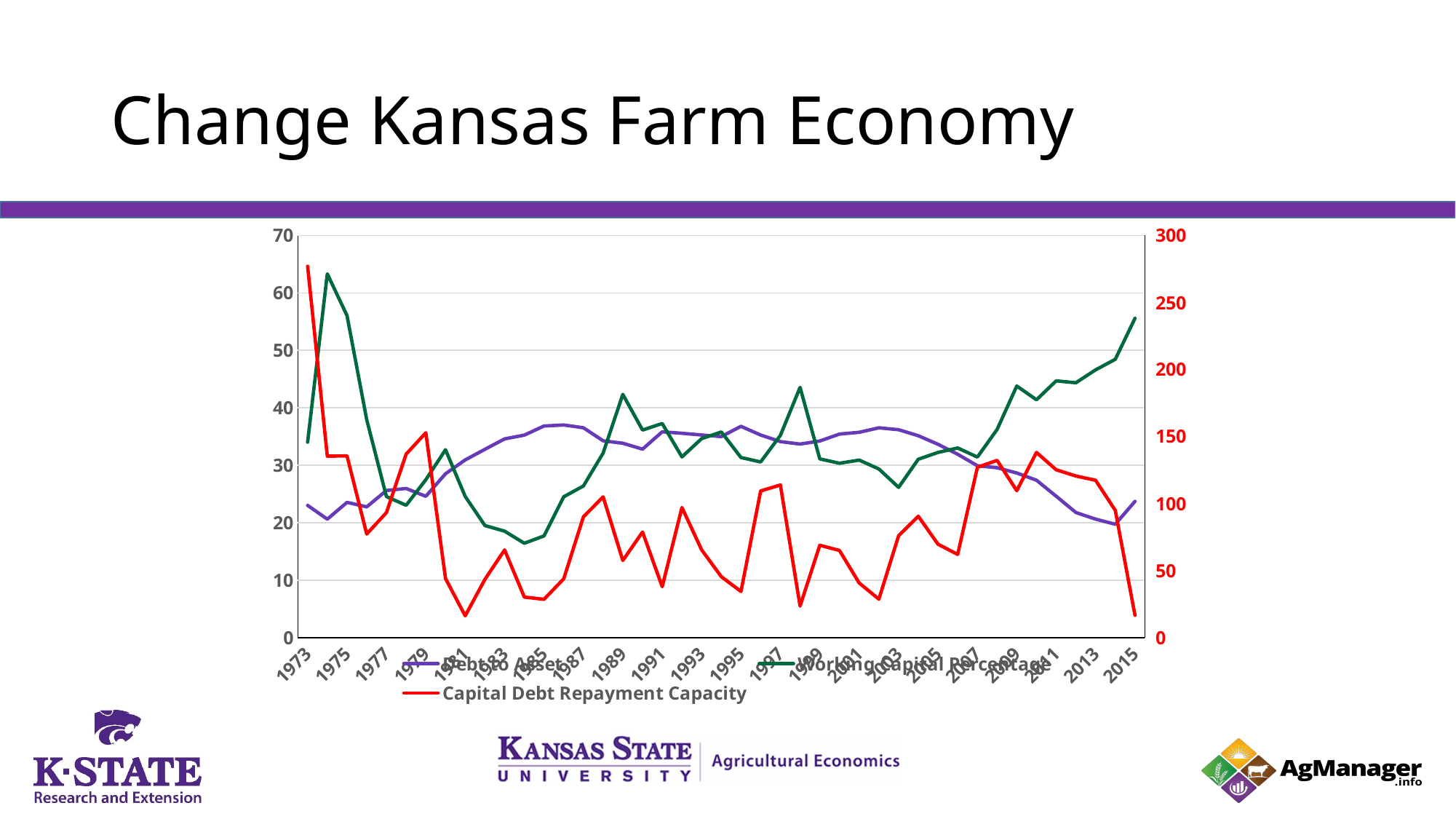
Reading against the left axis, is the Debt to Asset value in 1973 greater or less than 30? less What kind of chart is shown on the slide? Line chart Does the Debt to Asset line generally rise or fall from 2007 to 2013? Fall Which colour is used for the Capital Debt Repayment Capacity line? Red What is the title of the slide containing the chart? Change Kansas Farm Economy Reading against the right axis, is the Capital Debt Repayment Capacity value in 1981 greater or less than 50? less Reading against the left axis, is the Debt to Asset value in 1985 greater or less than 30? greater Does the Working Capital Percentage line generally rise or fall from 2007 to 2015? Rise How many series does the chart legend list? 3 In 2015, which line is plotted higher on the chart: Working Capital Percentage or Capital Debt Repayment Capacity? Working Capital Percentage